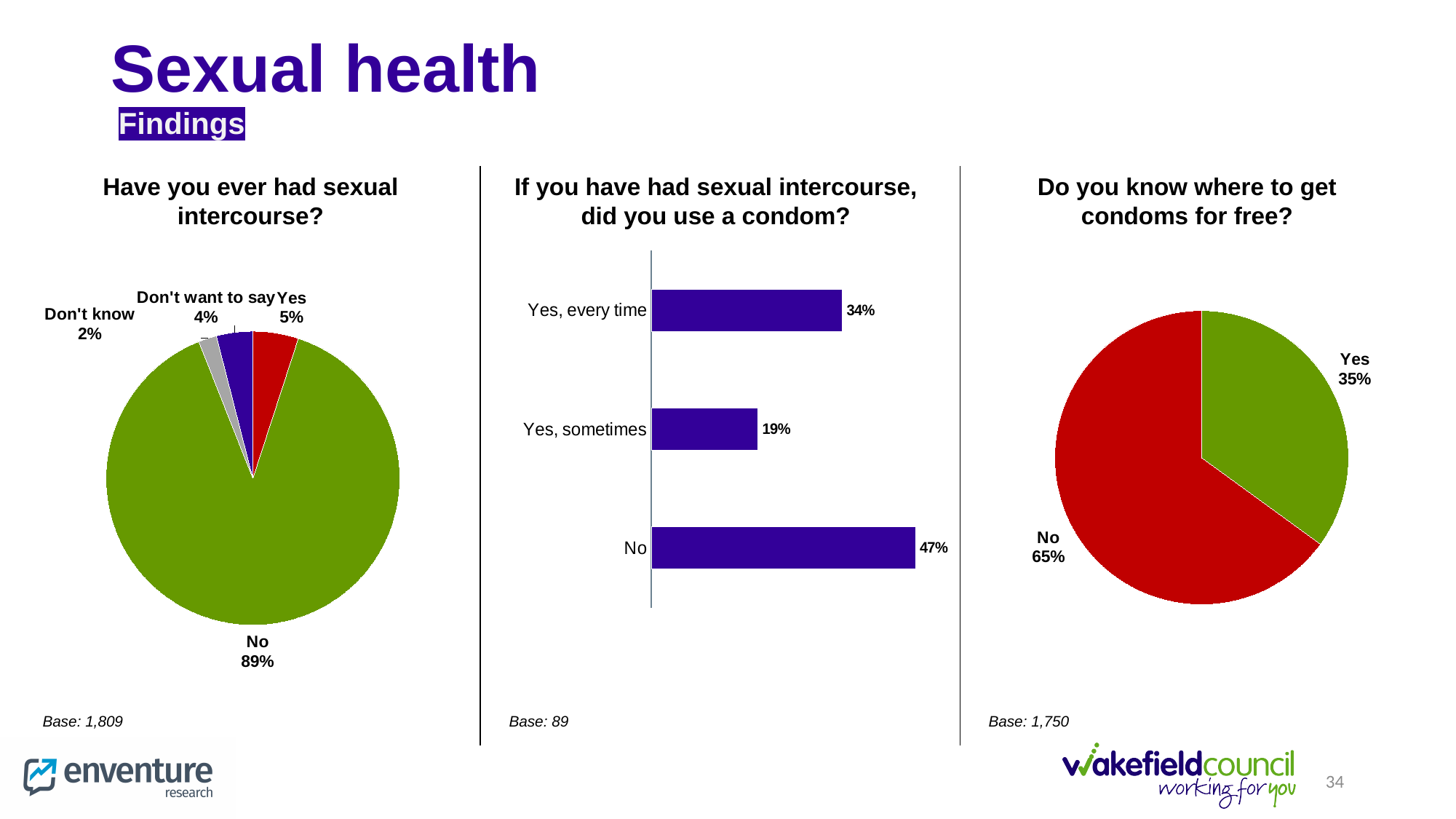
In the 'If you have had sexual intercourse, did you use a condom?' chart, what is the value for 'Yes, sometimes'? 19% In the 'If you have had sexual intercourse, did you use a condom?' chart, what is the difference between 'No' and 'Yes, every time'? 13% In the 'Have you ever had sexual intercourse?' chart, what percentage answered Yes? 5% What is the base shown for the 'If you have had sexual intercourse, did you use a condom?' chart? 89 In the 'Do you know where to get condoms for free?' chart, what percentage answered No? 65% In the 'Have you ever had sexual intercourse?' chart, what percentage answered No? 89% In the 'Have you ever had sexual intercourse?' chart, how many categories are shown? 4 What kind of chart is the 'If you have had sexual intercourse, did you use a condom?' chart? Bar chart In the 'If you have had sexual intercourse, did you use a condom?' chart, which category has the highest value? No In the 'If you have had sexual intercourse, did you use a condom?' chart, which is larger: 'Yes, every time' or 'Yes, sometimes'? Yes, every time In the 'Have you ever had sexual intercourse?' chart, which category has the smallest share? Don't know In the 'Do you know where to get condoms for free?' chart, what is the difference between No and Yes? 30%